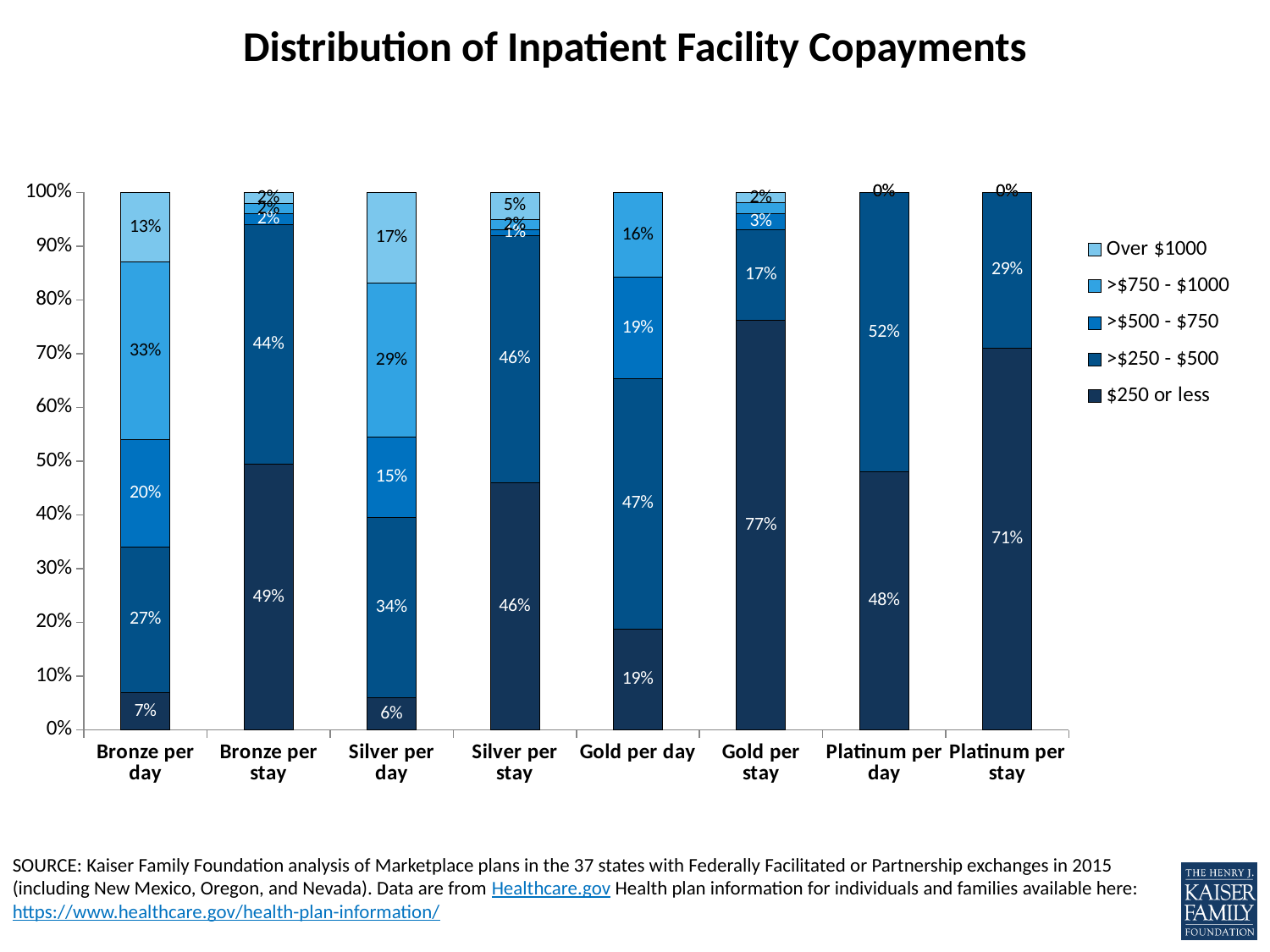
What is the title of the chart? Distribution of Inpatient Facility Copayments How many categories are shown along the x axis? 8 What share of Bronze per day copayments are $250 or less? 7% What kind of chart is shown on the slide? Stacked bar chart How many series does the legend list? 5 Which category has the smallest share of copayments that are $250 or less? Silver per day What share of Bronze per day copayments fall in the >$750 - $1000 range? 33% Which category has the largest share of copayments that are $250 or less? Gold per stay What share of Silver per day copayments are Over $1000? 17% What share of Gold per stay copayments are $250 or less? 77% What is the difference between the $250 or less share for Gold per stay and for Platinum per stay? 6 percentage points Which has a larger share of copayments that are $250 or less, Platinum per day or Platinum per stay? Platinum per stay